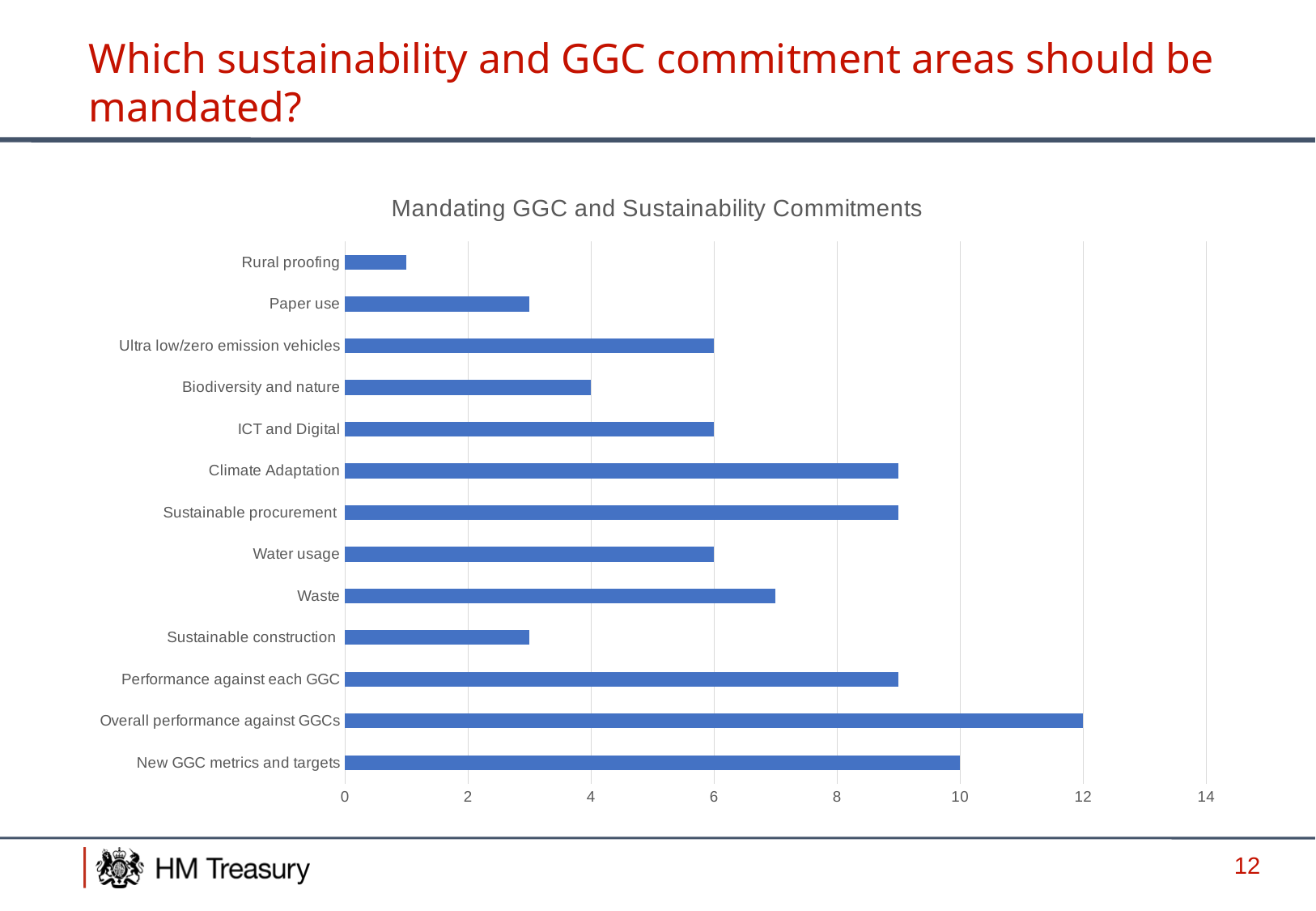
What is the value for Overall performance against GGCs? 12 Which has the larger value, Waste or Biodiversity and nature? Waste How many commitment areas are plotted in the chart? 13 Which commitment area has the lowest value? Rural proofing What is the value for Biodiversity and nature? 4 What is the value for New GGC metrics and targets? 10 What type of chart is shown on the slide? bar chart What is the title of the chart? Mandating GGC and Sustainability Commitments Which commitment area has the highest value? Overall performance against GGCs Is the value for Climate Adaptation greater or less than 8? greater What is the value for Water usage? 6 What is the difference between the values for Overall performance against GGCs and New GGC metrics and targets? 2